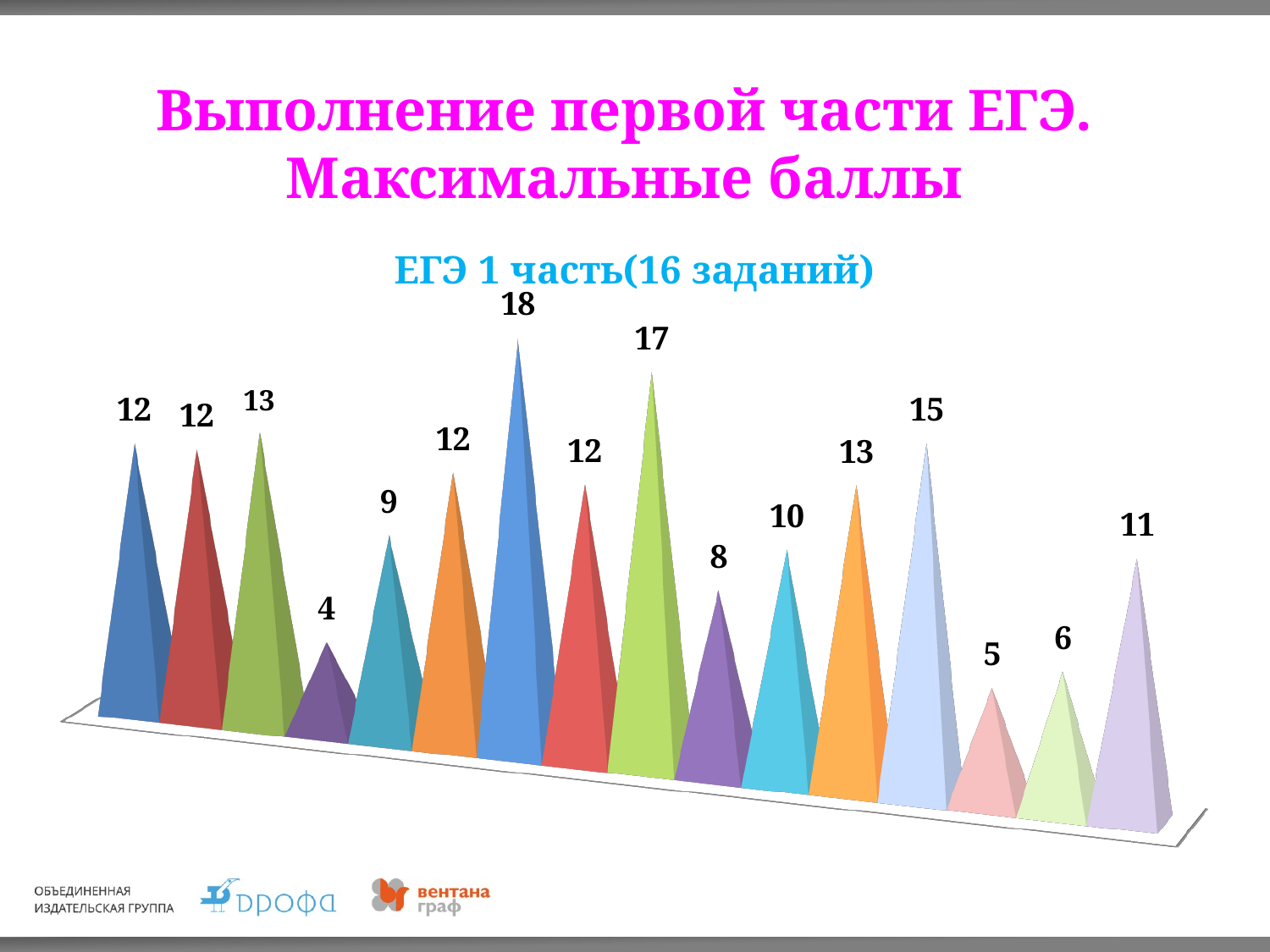
Which is larger: the ninth bar from the left (17) or the thirteenth bar from the left (15)? the ninth bar (17) What is the highest value shown in the chart? 18 What is the difference between the highest value (18) and the lowest value (4) in the chart? 14 What kind of chart is shown on the slide? bar chart What is the value of the fourth bar from the left? 4 How many bars are plotted in the chart? 16 What is the value of the last bar on the right? 11 What is the difference between the seventh bar (18) and the fifth bar (9)? 9 What is the value of the ninth bar from the left? 17 What is the value of the first bar from the left? 12 What is the title of the chart? ЕГЭ 1 часть(16 заданий) What is the lowest value shown in the chart? 4